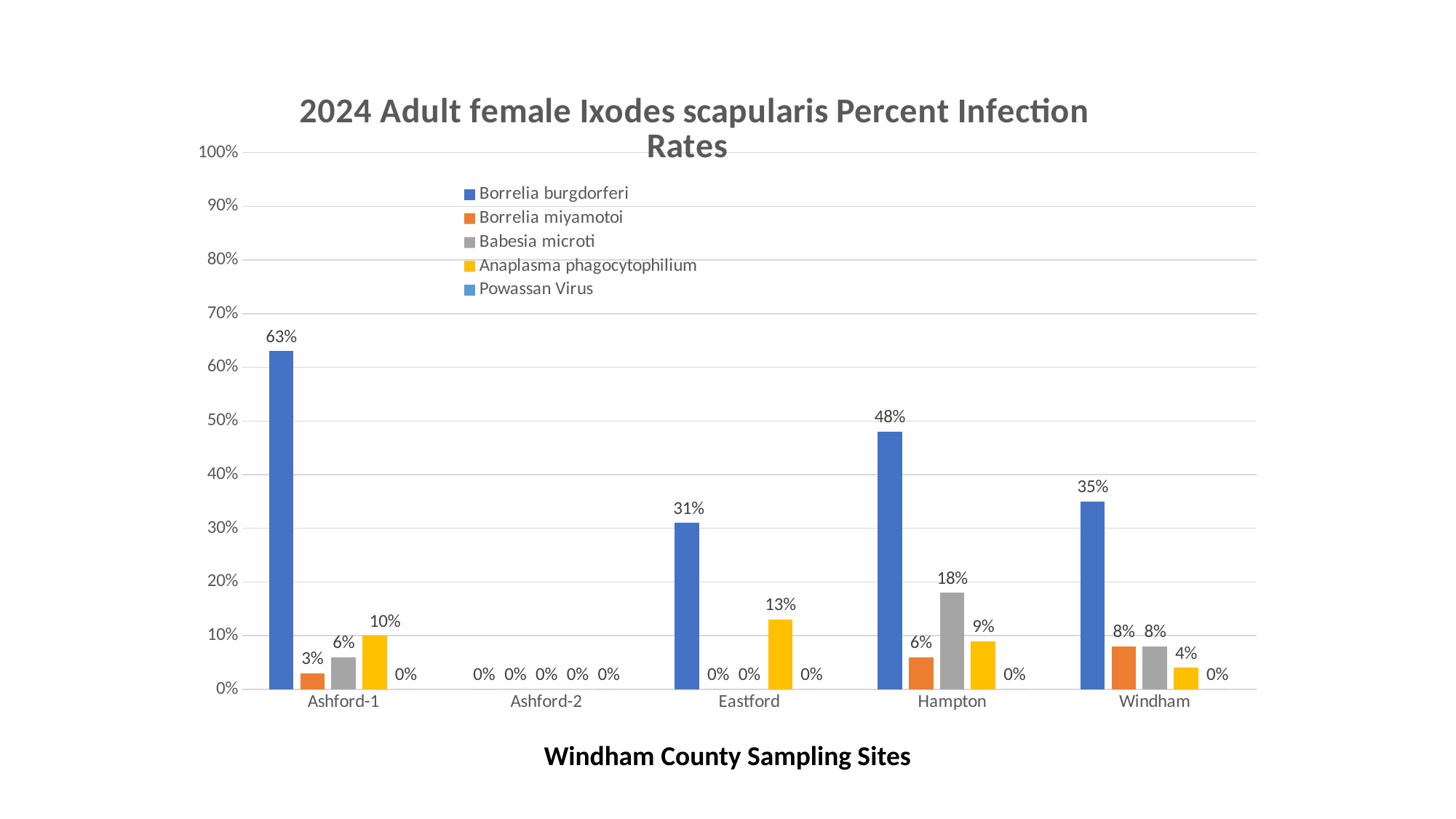
Which sampling site has the highest Borrelia burgdorferi infection rate? Ashford-1 What is the Borrelia miyamotoi infection rate at Windham? 8% Which sampling site has the lowest Borrelia burgdorferi infection rate? Ashford-2 Which is larger, the Anaplasma phagocytophilium rate at Ashford-1 or at Eastford? Eastford What kind of chart is shown on the slide? Bar chart What is the Anaplasma phagocytophilium infection rate at Eastford? 13% What is the x-axis title of the chart? Windham County Sampling Sites What is the Borrelia burgdorferi infection rate at Ashford-1? 63% What is the Babesia microti infection rate at Hampton? 18% How many sampling sites are shown on the x axis? 5 How many series does the legend list? 5 What is the difference between the Borrelia burgdorferi infection rates at Ashford-1 and Hampton? 15%